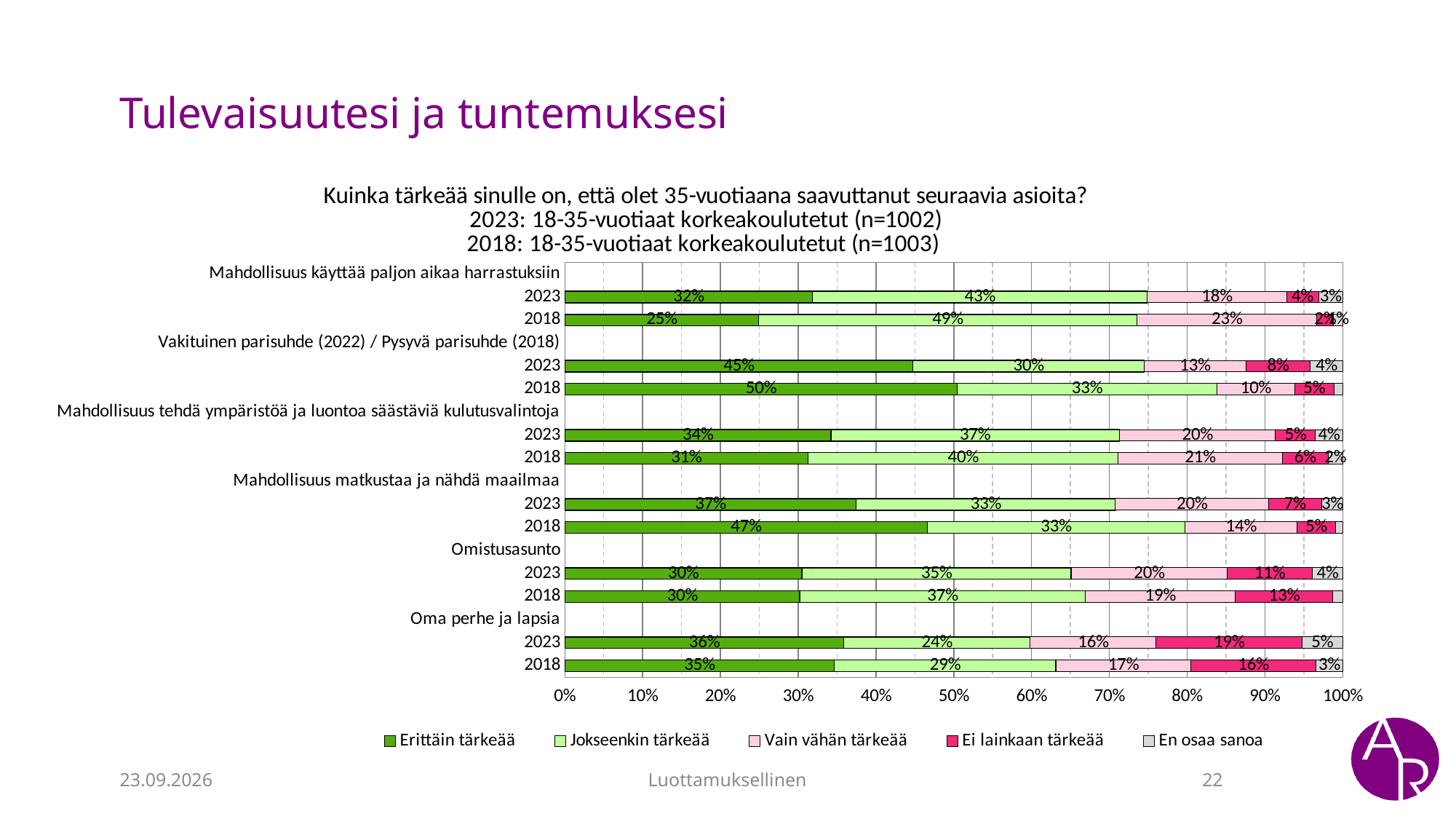
What is the "Jokseenkin tärkeää" value for Omistusasunto in 2018? 37% Which bar has the highest "Erittäin tärkeää" share? Vakituinen parisuhde (2022) / Pysyvä parisuhde (2018), 2018 (50%) Which bar has the lowest "Erittäin tärkeää" share? Mahdollisuus käyttää paljon aikaa harrastuksiin, 2018 (25%) Which legend entry is shown in the darkest green colour? Erittäin tärkeää How much higher is the "Erittäin tärkeää" share for Mahdollisuus matkustaa ja nähdä maailmaa in 2018 than in 2023? 10 percentage points How many series does the legend list? 5 For Oma perhe ja lapsia, is the "Ei lainkaan tärkeää" share larger in 2023 or in 2018? 2023 What kind of chart is shown on the slide? Stacked horizontal bar chart What percentage of respondents in 2023 said it is "Erittäin tärkeää" to have the opportunity to spend a lot of time on hobbies (Mahdollisuus käyttää paljon aikaa harrastuksiin)? 32% For Mahdollisuus käyttää paljon aikaa harrastuksiin, is the "Jokseenkin tärkeää" share larger in 2023 or in 2018? 2018 What is the "Vain vähän tärkeää" value for Mahdollisuus matkustaa ja nähdä maailmaa in 2018? 14% What is the "Ei lainkaan tärkeää" value for Oma perhe ja lapsia in 2023? 19%